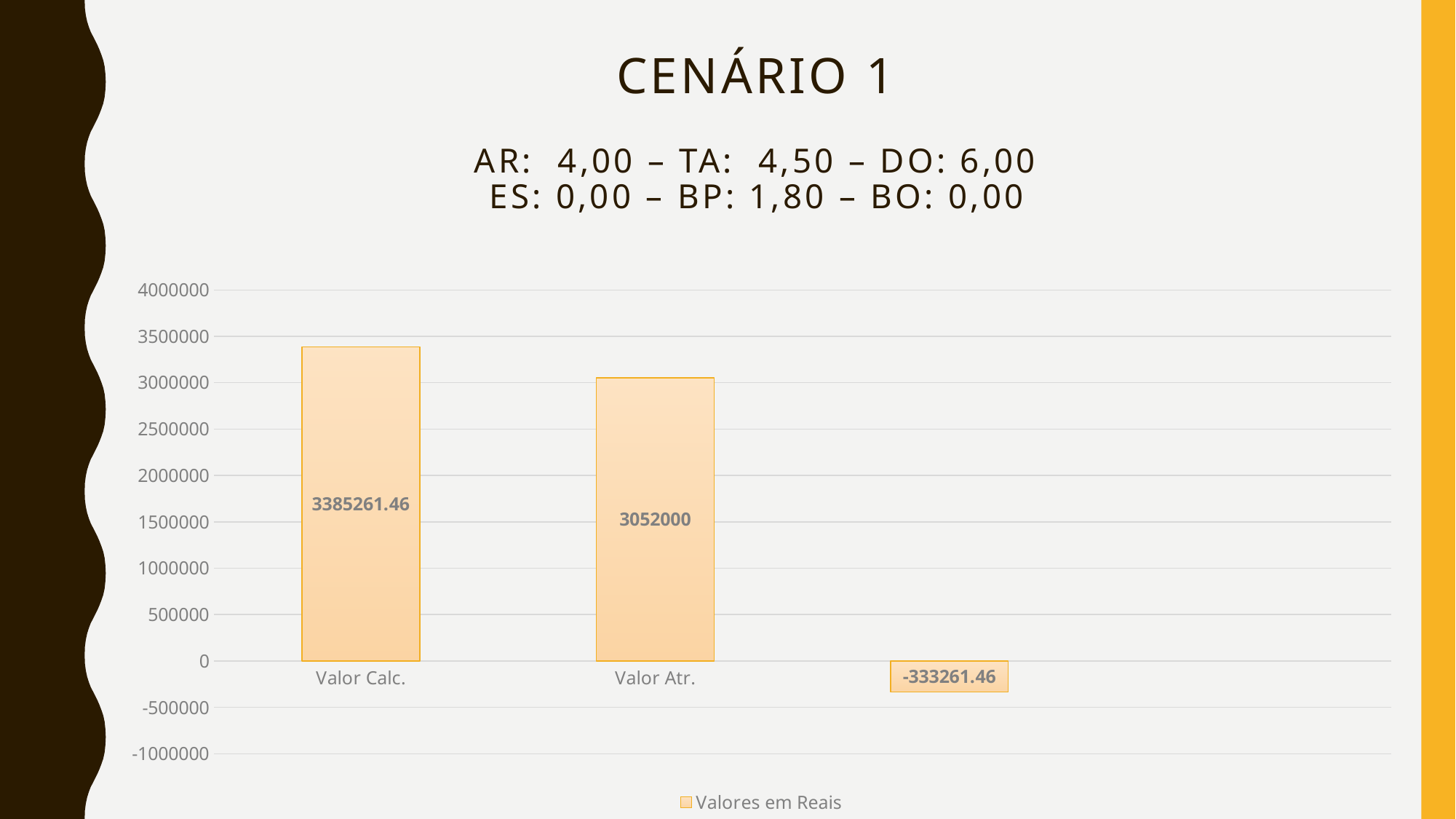
What is the difference between Valor Calc. and Valor Atr.? 333261.46 What is the value for Valor Calc.? 3385261.46 How many bars are plotted in the chart? 3 Is the value for Valor Calc. greater or less than 3000000? greater How many series does the legend list? 1 Which category has the highest value? Valor Calc. What is the value for Valor Atr.? 3052000 What value is printed on the rightmost bar of the chart? -333261.46 What kind of chart is shown on the slide? bar chart Is the value for Valor Atr. greater or less than 3500000? less What is the legend entry of the chart? Valores em Reais Which is larger, Valor Calc. or Valor Atr.? Valor Calc.